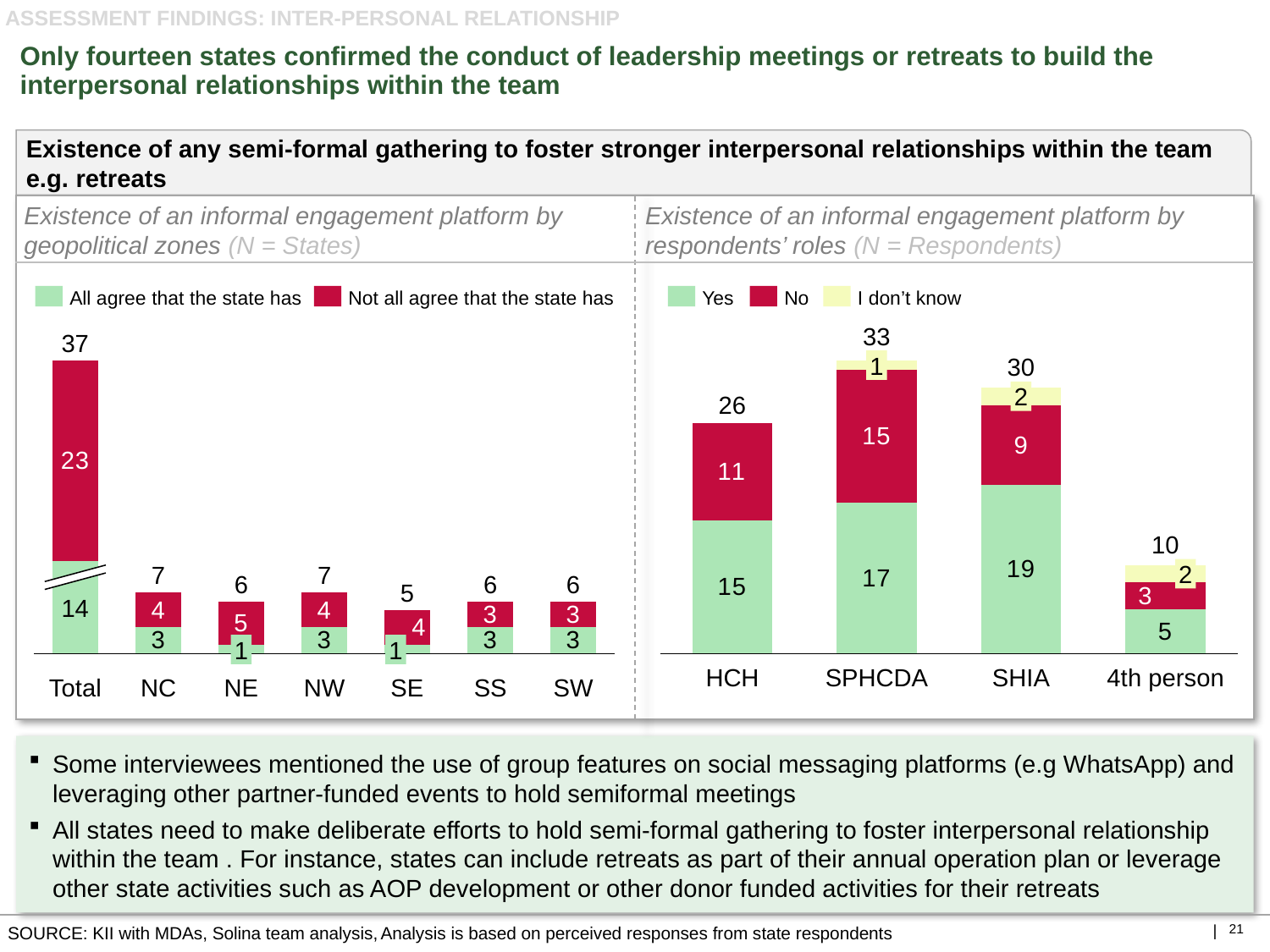
In the left chart (by geopolitical zones), what is the total value for the Total bar? 37 In the left chart (by geopolitical zones), which zone (excluding Total) has the lowest total? SE In the left chart (by geopolitical zones), how many states in the NE zone fall under 'Not all agree that the state has'? 5 In the left chart (by geopolitical zones), how many series does the legend list? 2 In the right chart (by respondents' roles), which role has the lowest total? 4th person In the right chart (by respondents' roles), what is the 'Yes' value for SHIA? 19 In the left chart (by geopolitical zones), how many categories are shown on the x axis, including Total? 7 In the right chart (by respondents' roles), what is the difference between the 'No' values for SPHCDA and SHIA? 6 What type of chart is the right chart (by respondents' roles)? Stacked bar chart In the right chart (by respondents' roles), is the 'Yes' value for HCH larger or smaller than the 'No' value for HCH? larger In the right chart (by respondents' roles), which role has the highest total? SPHCDA In the left chart (by geopolitical zones), what is the difference between the 'Not all agree' and 'All agree' values for the Total bar? 9